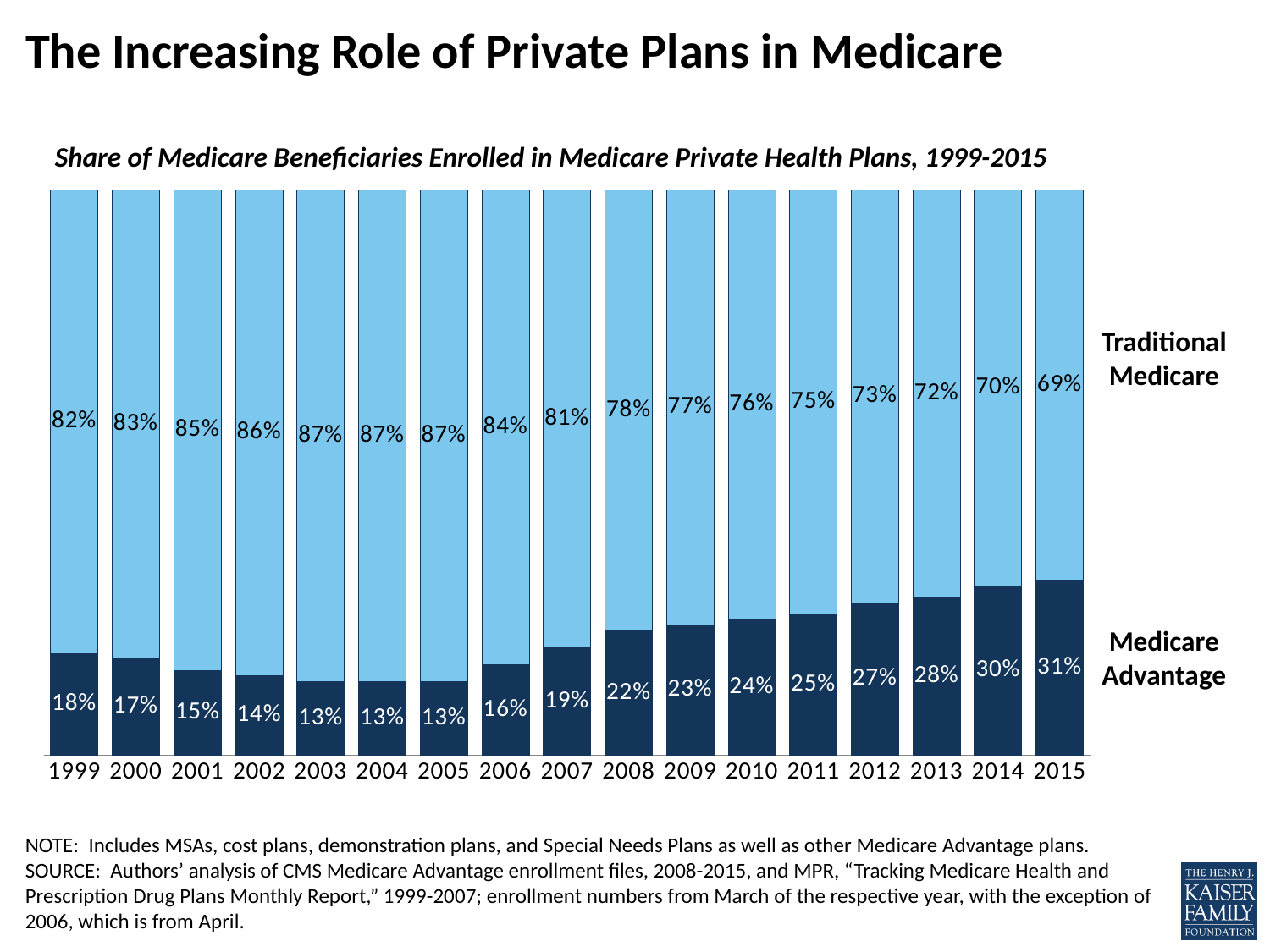
What is the total of the Traditional Medicare and Medicare Advantage shares for 2012? 100% What kind of chart is shown on the slide? Stacked bar chart How many series does the chart show? 2 What share of Medicare beneficiaries were in Traditional Medicare in 1999? 82% Does the Medicare Advantage share rise or fall from 2005 to 2015? Rise Which year has the lowest Traditional Medicare share? 2015 How many years are shown on the x axis? 17 What share of Medicare beneficiaries were enrolled in Medicare Advantage in 2015? 31% Which is larger, the Medicare Advantage share in 2003 or in 2010? 2010 What is the Medicare Advantage share for 2008? 22% What is the difference between the Medicare Advantage share in 2015 and in 1999? 13 percentage points Which year has the highest Medicare Advantage share? 2015